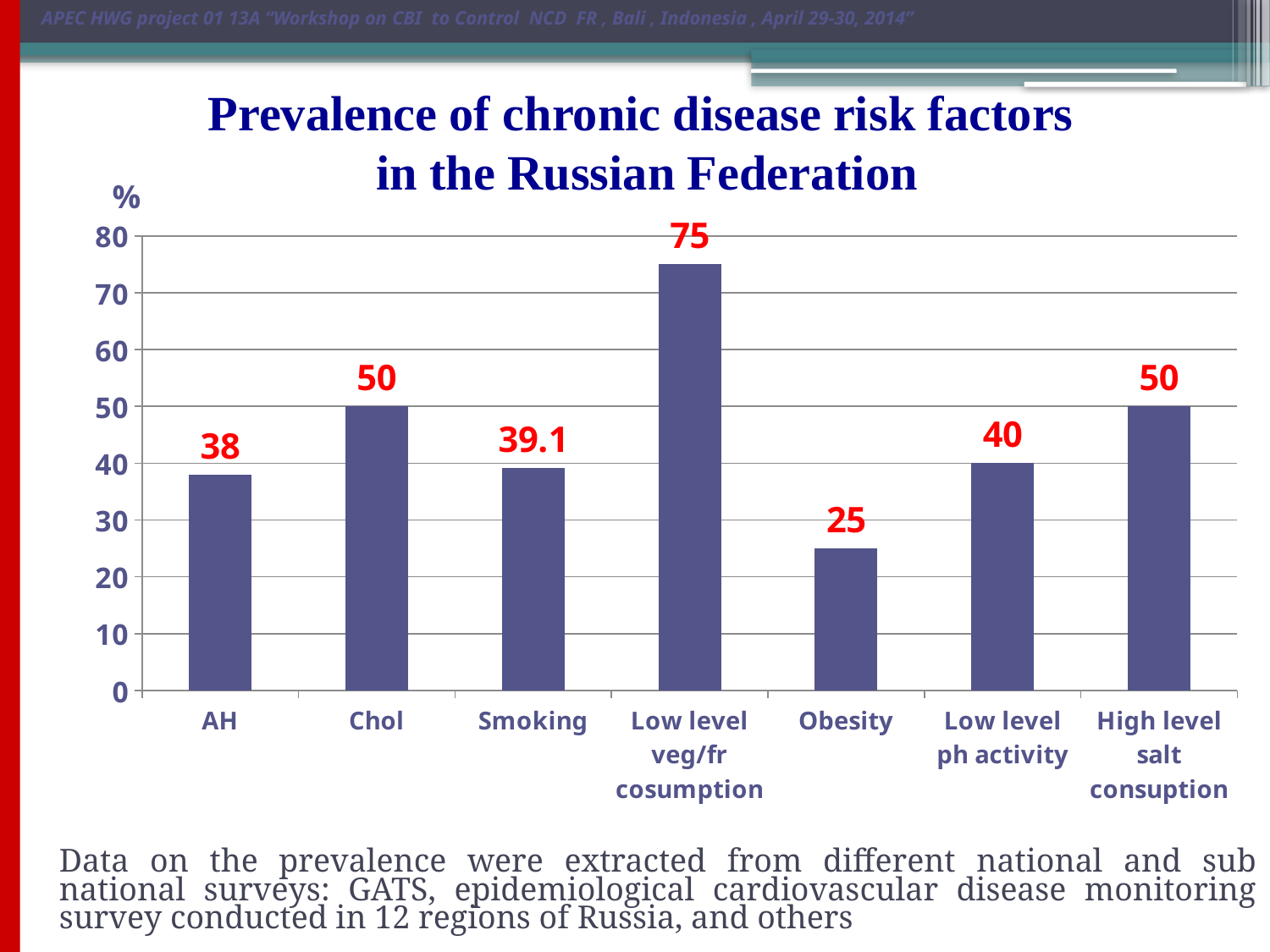
How many categories are shown on the x axis? 7 Which category has the lowest value? Obesity What is the difference between the values for Low level veg/fr cosumption and Obesity? 50 What is the value for Smoking? 39.1 Which is larger, the value for Chol or the value for Low level ph activity? Chol What is the value for AH? 38 What is the value for Low level ph activity? 40 What is the value for Obesity? 25 Which category has the highest value? Low level veg/fr cosumption What is the title of the chart? Prevalence of chronic disease risk factors in the Russian Federation What kind of chart is shown on the slide? Bar chart What is the difference between the values for Chol and AH? 12